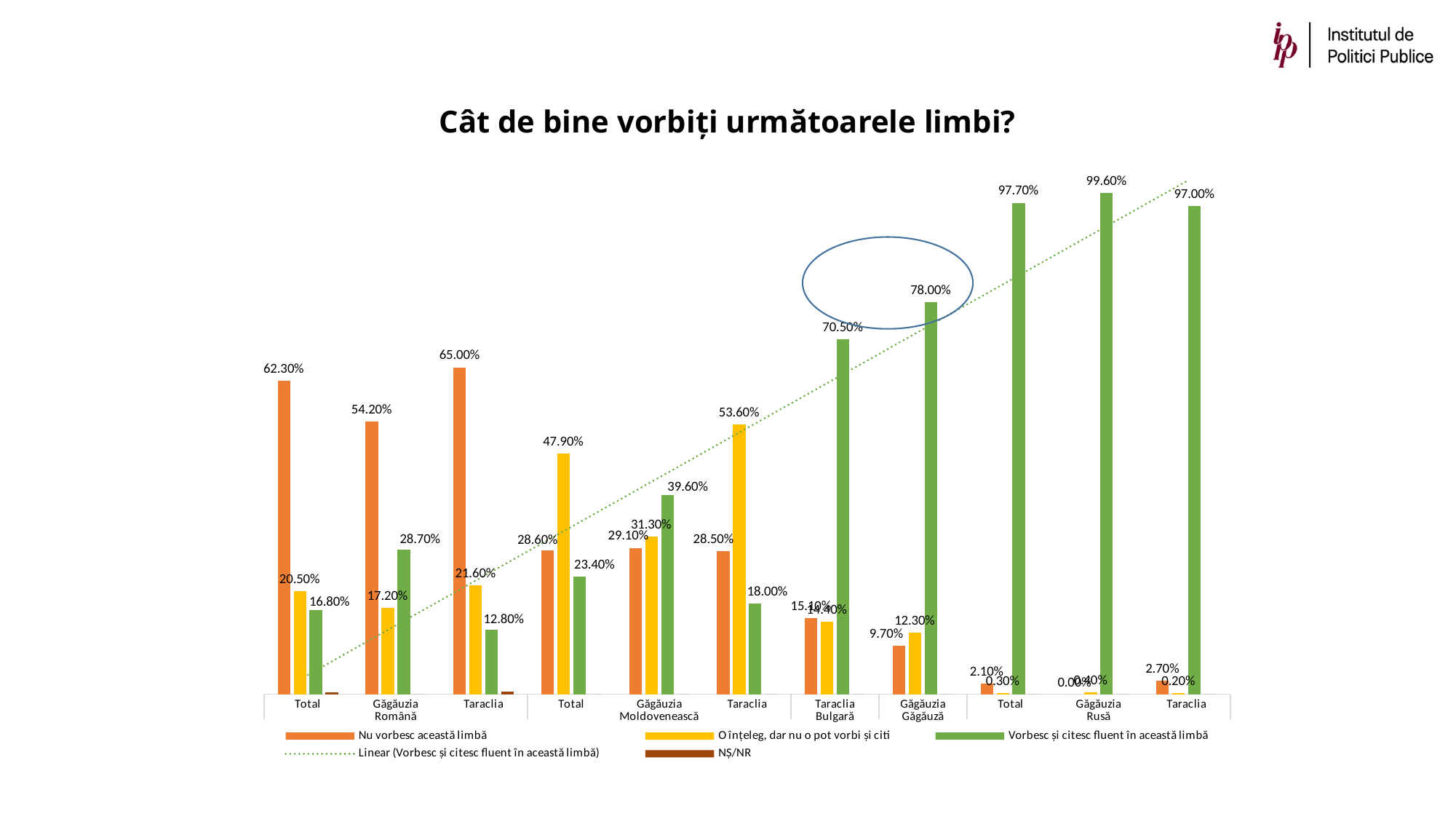
What is the title of the chart? Cât de bine vorbiți următoarele limbi? How many categories are shown on the x axis? 11 Which category has the highest value for 'Vorbesc și citesc fluent în această limbă'? Găgăuzia (Rusă) What is the difference between the 'Vorbesc și citesc fluent în această limbă' values for Găgăuzia under Găgăuză and Taraclia under Bulgară? 7.50% Which category has the lowest value for 'Nu vorbesc această limbă'? Găgăuzia (Rusă) Which is larger: 'Nu vorbesc această limbă' for Total under Română or for Găgăuzia under Română? Total under Română What is the value of 'Nu vorbesc această limbă' for Taraclia under Română? 65.00% What is the value of 'Vorbesc și citesc fluent în această limbă' for Găgăuzia under Rusă? 99.60% What is the value of 'Vorbesc și citesc fluent în această limbă' for Găgăuzia under Găgăuză? 78.00% How many series does the legend list? 5 What type of chart is shown on the slide? Bar chart What is the value of 'O înțeleg, dar nu o pot vorbi și citi' for Total under Moldovenească? 47.90%